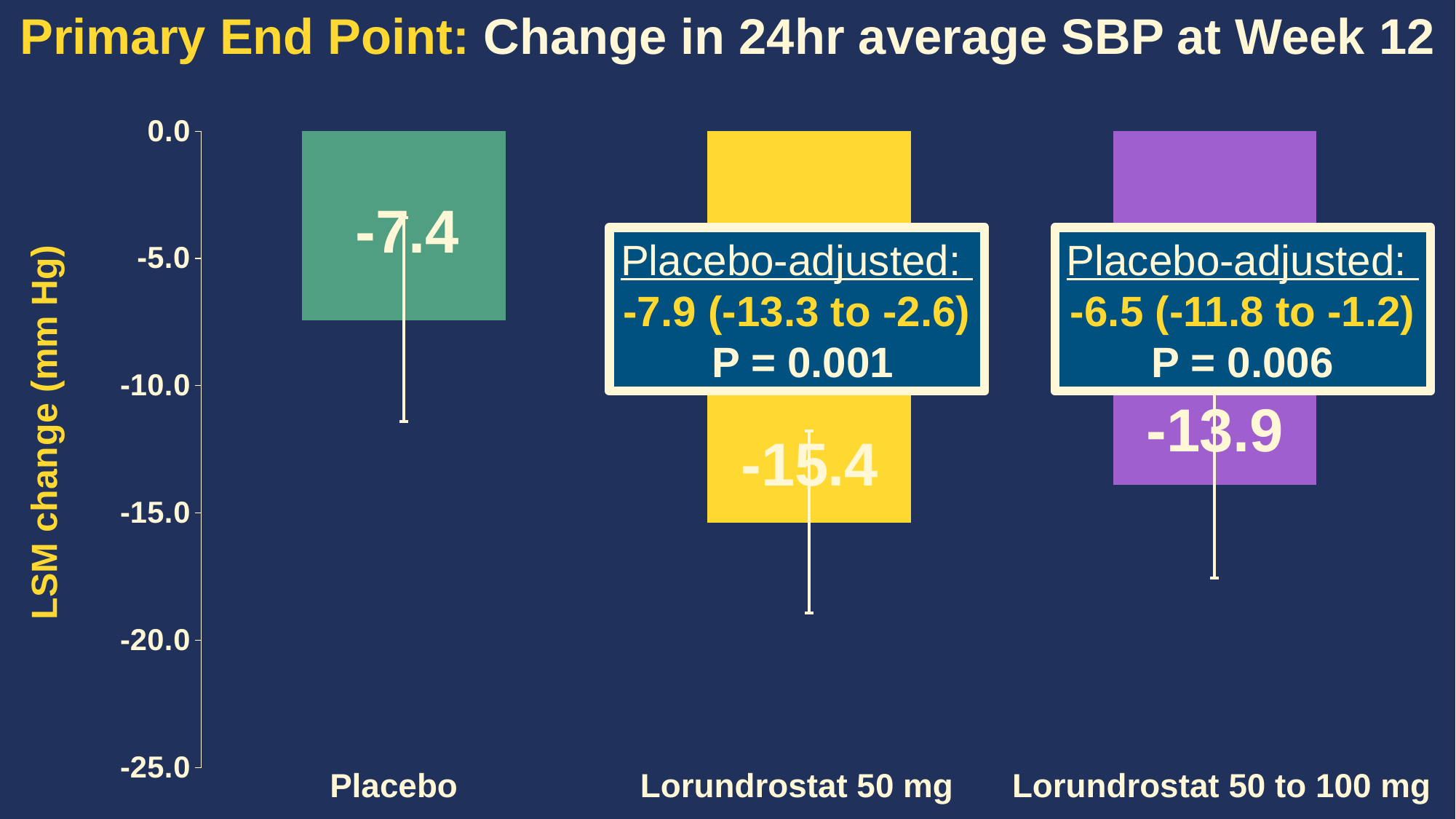
Which group shows the largest reduction (most negative LSM change) in 24hr average SBP? Lorundrostat 50 mg What is the label of the y-axis? LSM change (mm Hg) What is the LSM change in 24hr average SBP for Lorundrostat 50 mg? -15.4 How many treatment groups are shown in the chart? 3 Which group has a larger reduction in SBP: Lorundrostat 50 to 100 mg or Placebo? Lorundrostat 50 to 100 mg What is the difference between the LSM change for Lorundrostat 50 mg and Placebo? 8.0 mm Hg Which group shows the smallest reduction (least negative LSM change) in 24hr average SBP? Placebo What type of chart is shown on the slide? Bar chart What is the placebo-adjusted change and P value shown for Lorundrostat 50 mg? -7.9 (-13.3 to -2.6), P = 0.001 What is the difference between the LSM change for Lorundrostat 50 mg and Lorundrostat 50 to 100 mg? 1.5 mm Hg What is the LSM change in 24hr average SBP for the Placebo group? -7.4 What is the LSM change in 24hr average SBP for Lorundrostat 50 to 100 mg? -13.9